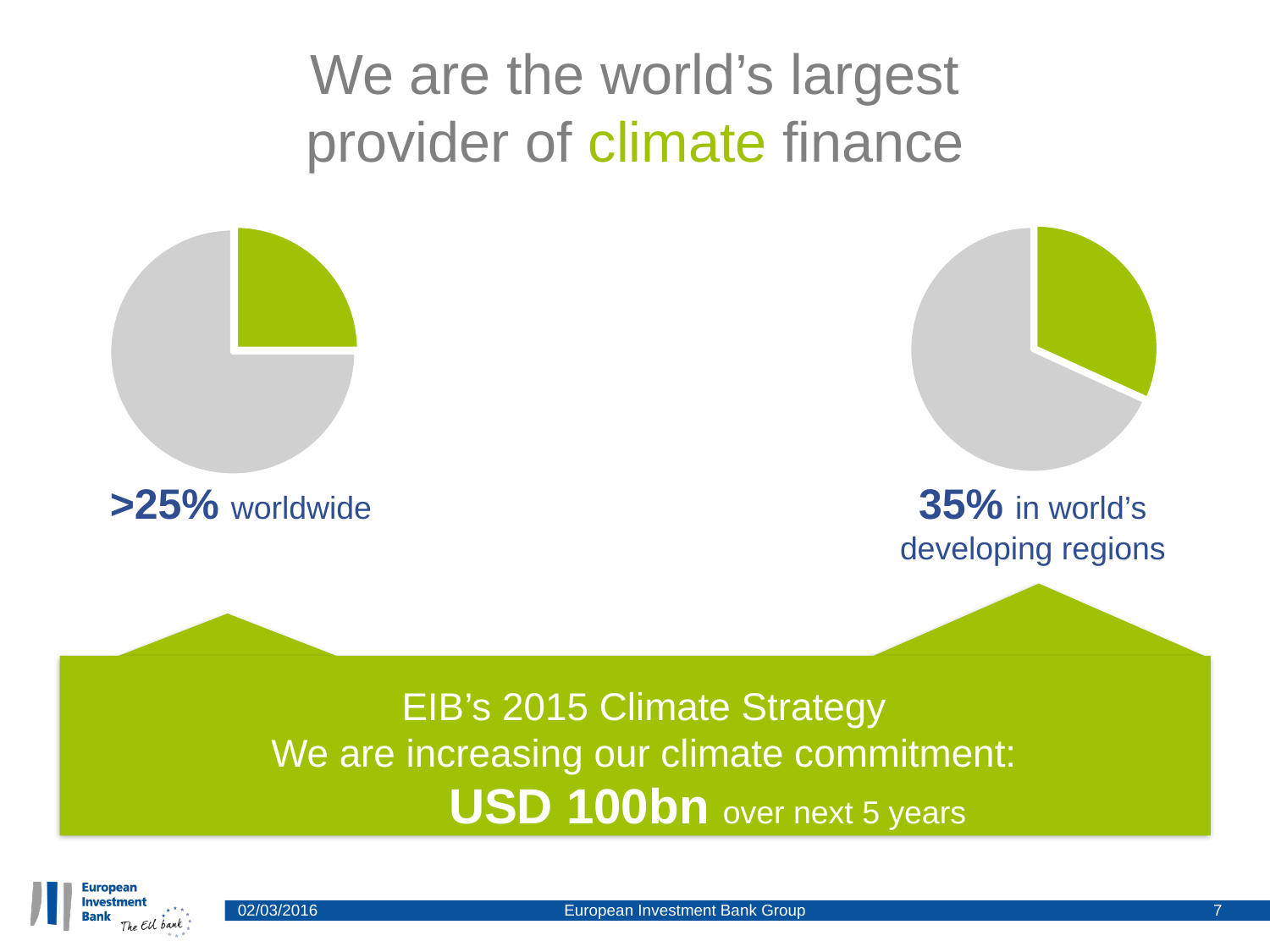
Which pie chart has the larger green slice, the left one (worldwide) or the right one (developing regions)? the right one (developing regions) What kind of chart is shown on the right side of the slide? pie chart How many pie charts are shown on the slide? 2 How many slices does the left pie chart have? 2 What label accompanies the left pie chart? >25% worldwide What colour is the highlighted slice in both pie charts? green In the left pie chart, what share does the green slice represent worldwide? >25% In the right pie chart, what share does the green slice represent in the world's developing regions? 35% What kind of chart is shown on the left side of the slide? pie chart How many slices does the right pie chart have? 2 In the right pie chart, is the green slice greater or less than 50% of the pie? less